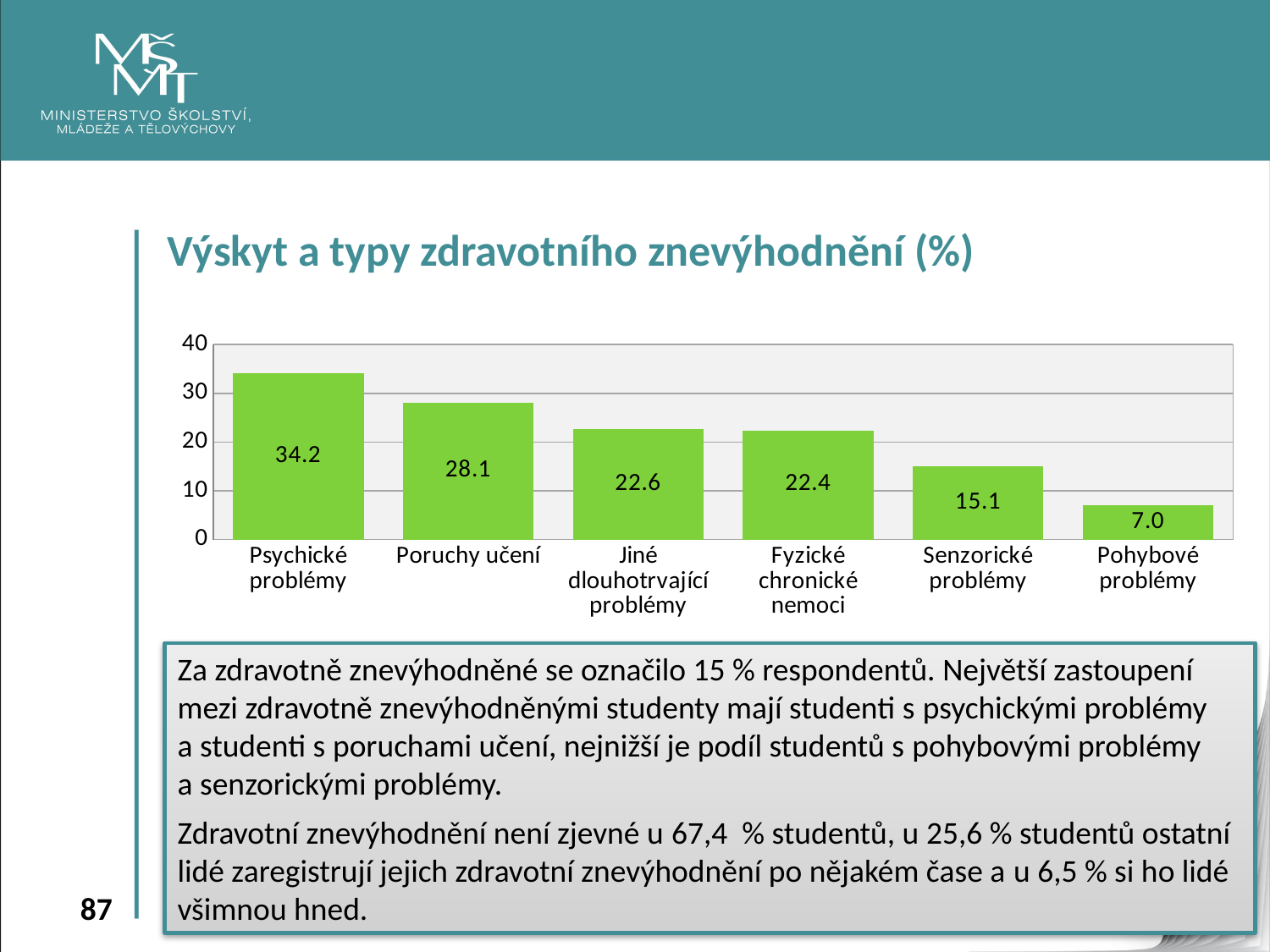
What is the value for Fyzické chronické nemoci? 22.4 What is the value for Psychické problémy? 34.2 What is the value for Senzorické problémy? 15.1 Which category has the highest value? Psychické problémy What is the difference between the values for Senzorické problémy and Pohybové problémy? 8.1 Which category has the lowest value? Pohybové problémy What is the title of the chart? Výskyt a typy zdravotního znevýhodnění (%) What is the difference between the values for Psychické problémy and Poruchy učení? 6.1 How many categories are shown in the chart? 6 Is the value for Pohybové problémy greater or less than 10? less What kind of chart is shown on the slide? bar chart Which is larger, the value for Poruchy učení or the value for Jiné dlouhotrvající problémy? Poruchy učení